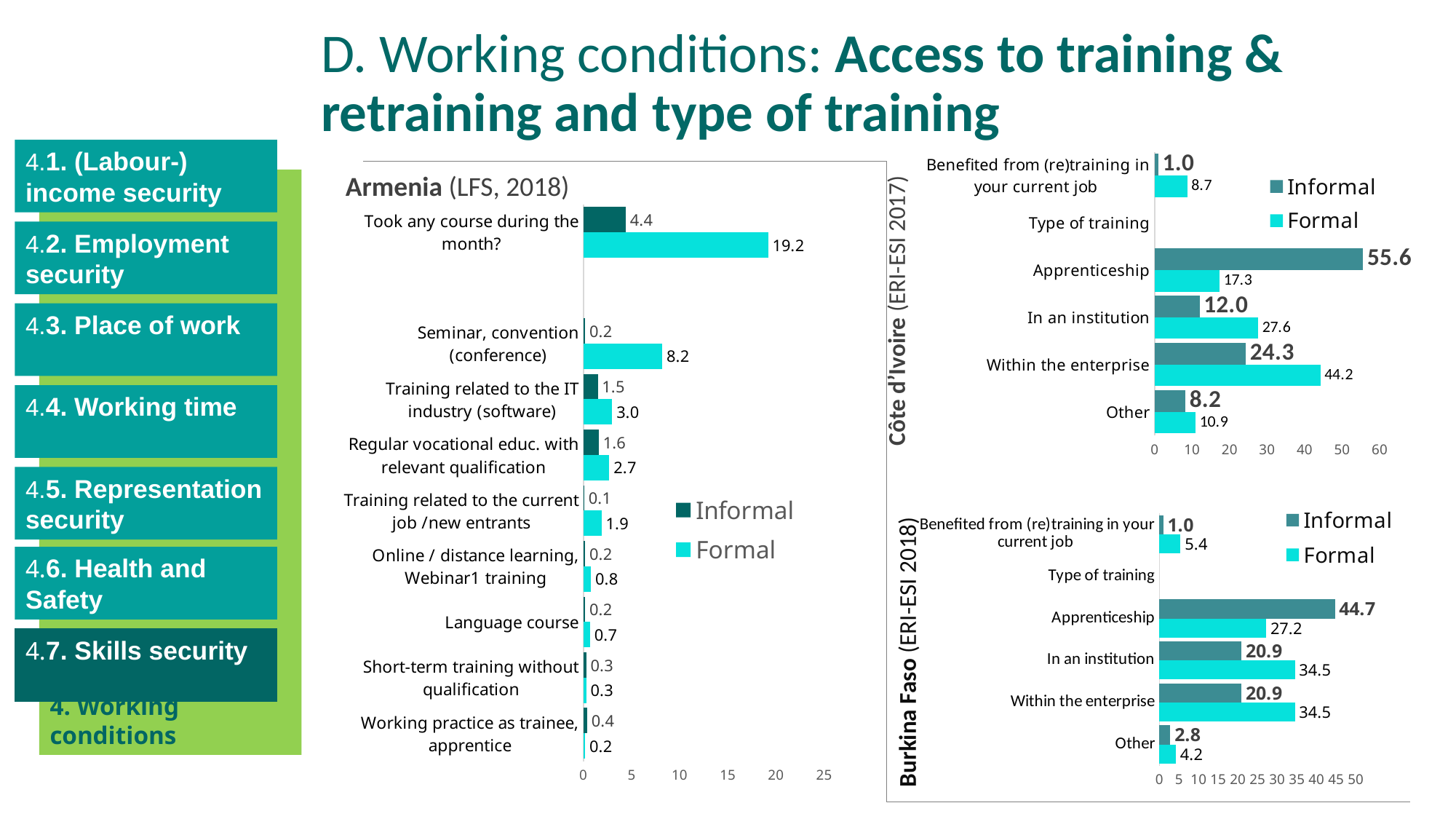
In the Côte d'Ivoire (ERI-ESI 2017) chart, which is larger for 'In an institution': the Informal or the Formal value? Formal In the Côte d'Ivoire (ERI-ESI 2017) chart, what is the difference between the Formal and Informal values for 'Within the enterprise'? 19.9 What type of chart is the Armenia (LFS, 2018) chart? Bar chart In the Burkina Faso (ERI-ESI 2018) chart, what is the difference between the Formal and Informal values for 'Other'? 1.4 In the Armenia (LFS, 2018) chart, what is the Informal value for 'Training related to the IT industry (software)'? 1.5 In the Burkina Faso (ERI-ESI 2018) chart, what is the Formal value for Apprenticeship? 27.2 In the Burkina Faso (ERI-ESI 2018) chart, which category has the lowest Informal value? Benefited from (re)training in your current job In the Armenia (LFS, 2018) chart, which category has the highest Formal value? Took any course during the month? In the Armenia (LFS, 2018) chart, how many series does the legend list? 2 In the Armenia (LFS, 2018) chart, what is the difference between the Formal and Informal values for 'Seminar, convention (conference)'? 8.0 In the Côte d'Ivoire (ERI-ESI 2017) chart, what is the Informal value for Apprenticeship? 55.6 In the Armenia (LFS, 2018) chart, what is the Formal value for 'Took any course during the month?' 19.2